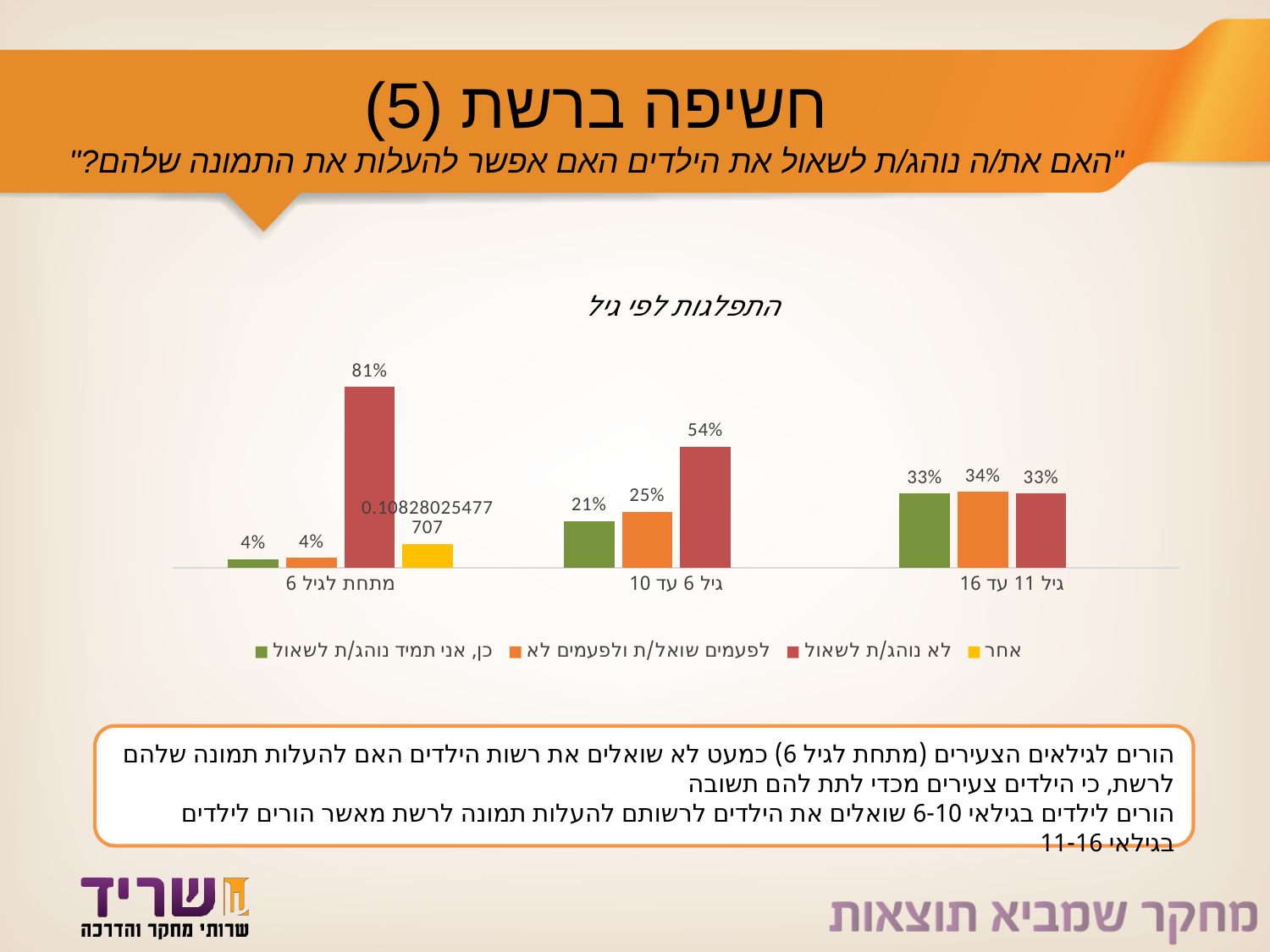
What is the value of the orange bar for the category גיל 11 עד 16? 34% In which age category is the red bar highest? מתחת לגיל 6 What is the value of the red bar for the category גיל 6 עד 10? 54% What is the title of the chart? התפלגות לפי גיל Which is larger: the orange bar for גיל 6 עד 10 or the orange bar for גיל 11 עד 16? גיל 11 עד 16 What is the value of the green bar for the category גיל 6 עד 10? 21% What is the difference between the red bar for מתחת לגיל 6 and the red bar for גיל 6 עד 10? 27% In which age category is the green bar lowest? מתחת לגיל 6 How many series does the chart legend list? 4 How many age categories are shown on the x axis of the chart? 3 What is the value of the red bar for the category מתחת לגיל 6? 81% What type of chart is shown on the slide? bar chart